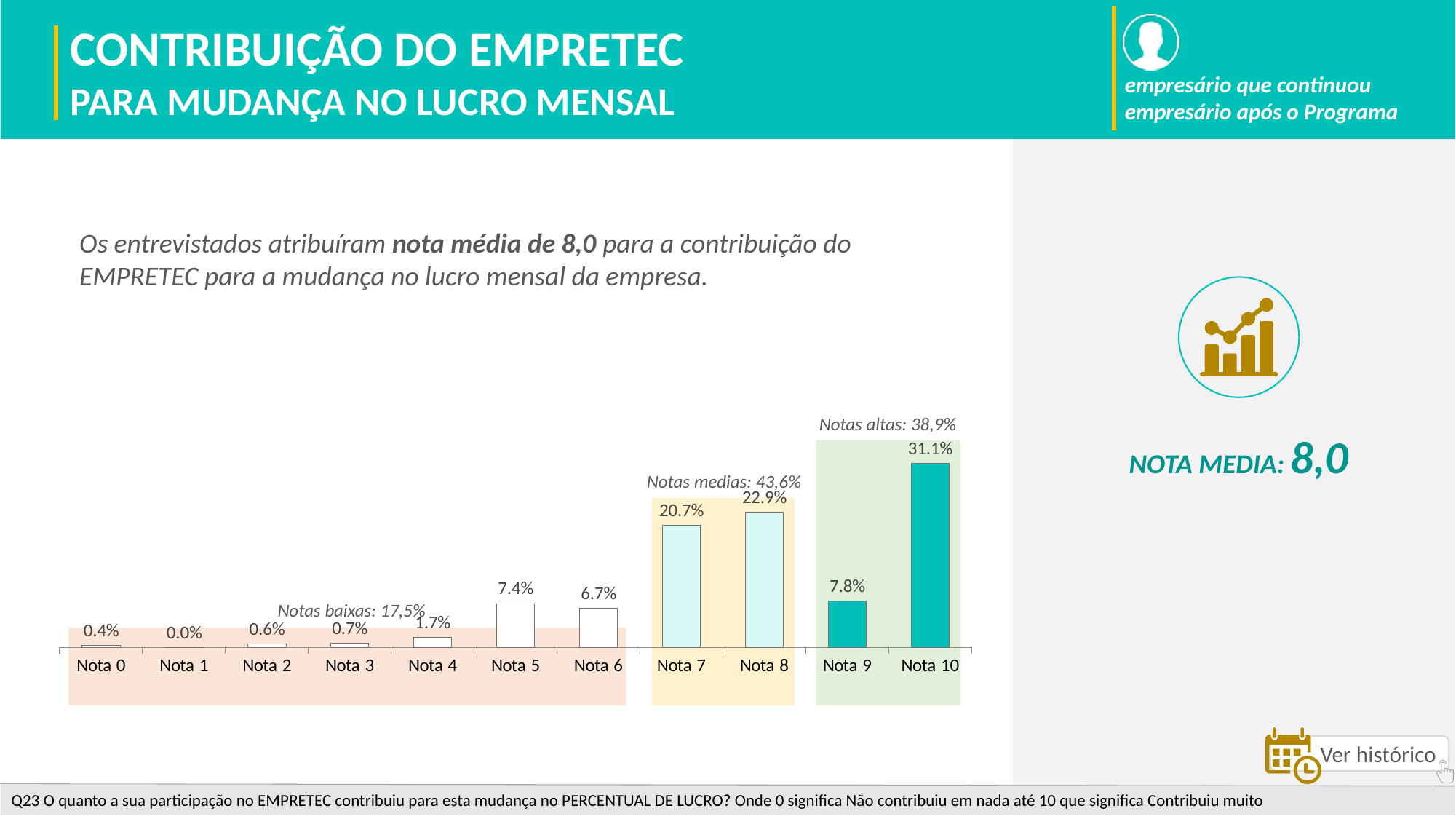
Which category has the highest value? Nota 10 Which is larger, the value for Nota 8 or the value for Nota 9? Nota 8 What is the difference between the values for Nota 5 and Nota 6? 0.7% What is the value shown for Nota 4? 1.7% How many categories (notas) are shown on the x axis? 11 What percentage of respondents gave Nota 10? 31.1% Which category has the lowest value? Nota 1 What is the value shown for Nota 7? 20.7% What kind of chart is shown on the slide? Bar chart What is the difference between the values for Nota 10 and Nota 8? 8.2% What percentage is shown for the group labelled 'Notas altas'? 38,9% What percentage is shown for the group labelled 'Notas medias'? 43,6%